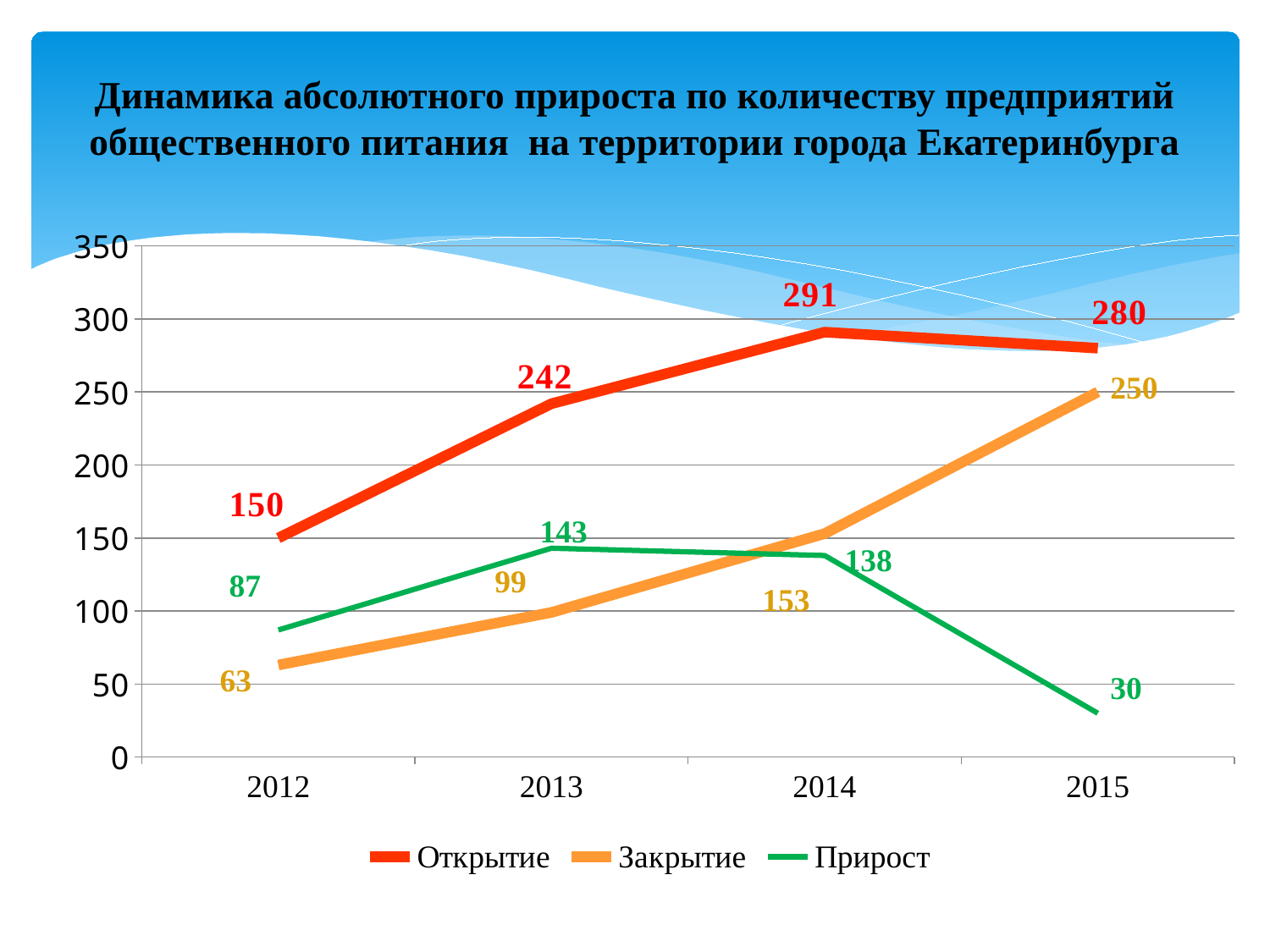
What is the value of Открытие in 2014? 291 What type of chart is shown on the slide? Line chart Does the Закрытие series rise or fall from 2012 to 2015? Rises Which series is drawn in green? Прирост What is the value of Прирост in 2012? 87 In which year is Прирост lowest? 2015 How many years are plotted on the x axis? 4 How many series does the legend list? 3 In which year is Открытие highest? 2014 What is the value of Закрытие in 2015? 250 Which is larger in 2015: Закрытие or Прирост? Закрытие What is the difference between Открытие and Закрытие in 2013? 143